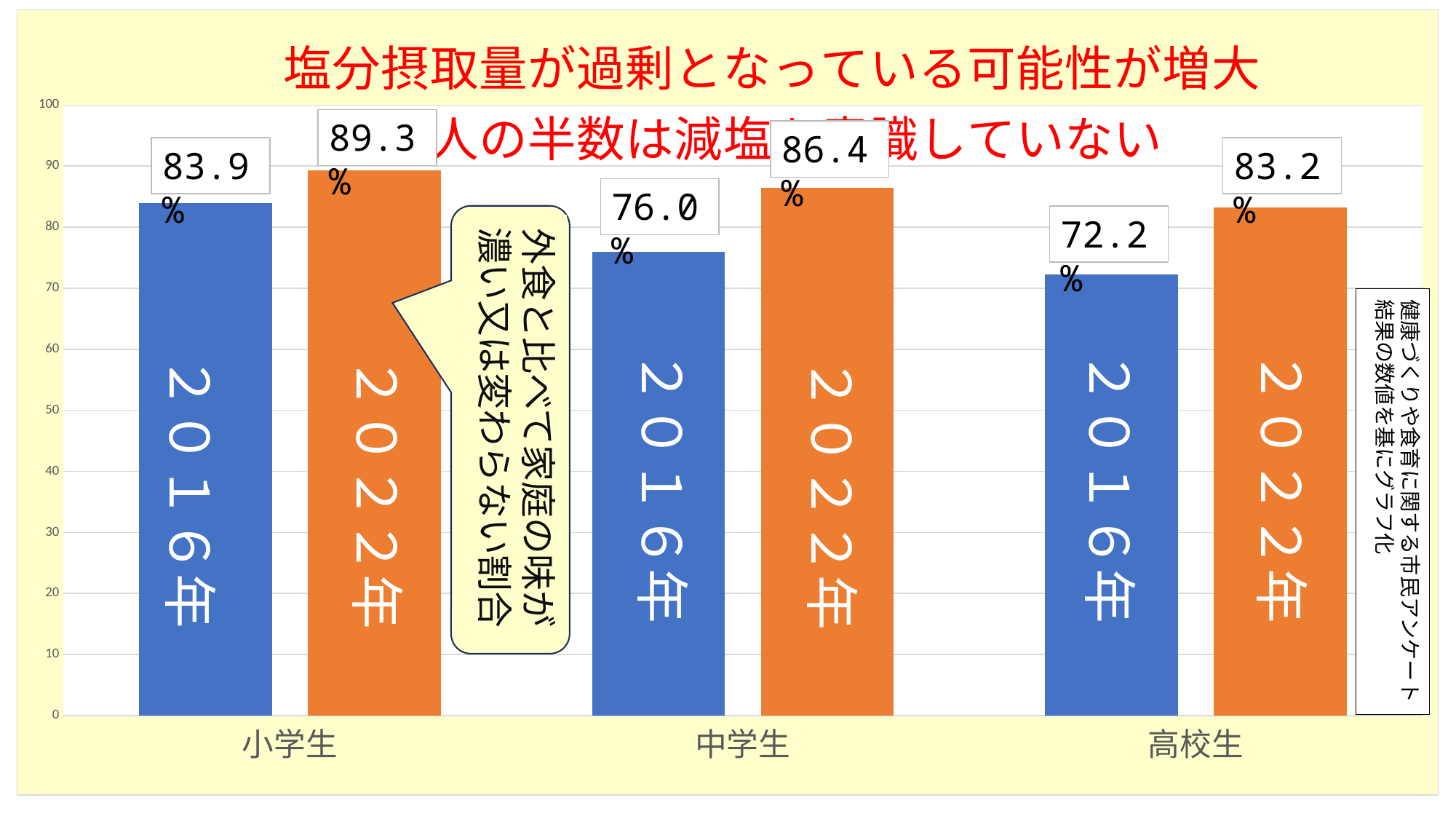
Which is larger, the 2016年 value for 小学生 or the 2022年 value for 高校生? 2016年 value for 小学生 (83.9%) What is the difference between the 2022年 and 2016年 values for 中学生? 10.4% Is the 2016年 value for 高校生 greater or less than 80? less What is the value for 高校生 in 2016年? 72.2% Which bar has the highest value on the chart? 小学生 2022年 (89.3%) What is the value for 中学生 in 2022年? 86.4% What is the difference between the 2022年 and 2016年 values for 高校生? 11.0% How many categories are shown on the x axis? 3 What is the value for 小学生 in 2016年? 83.9% Which bar has the lowest value on the chart? 高校生 2016年 (72.2%) Do the 2016年 values rise or fall from 小学生 to 高校生? fall What kind of chart is shown on the slide? bar chart